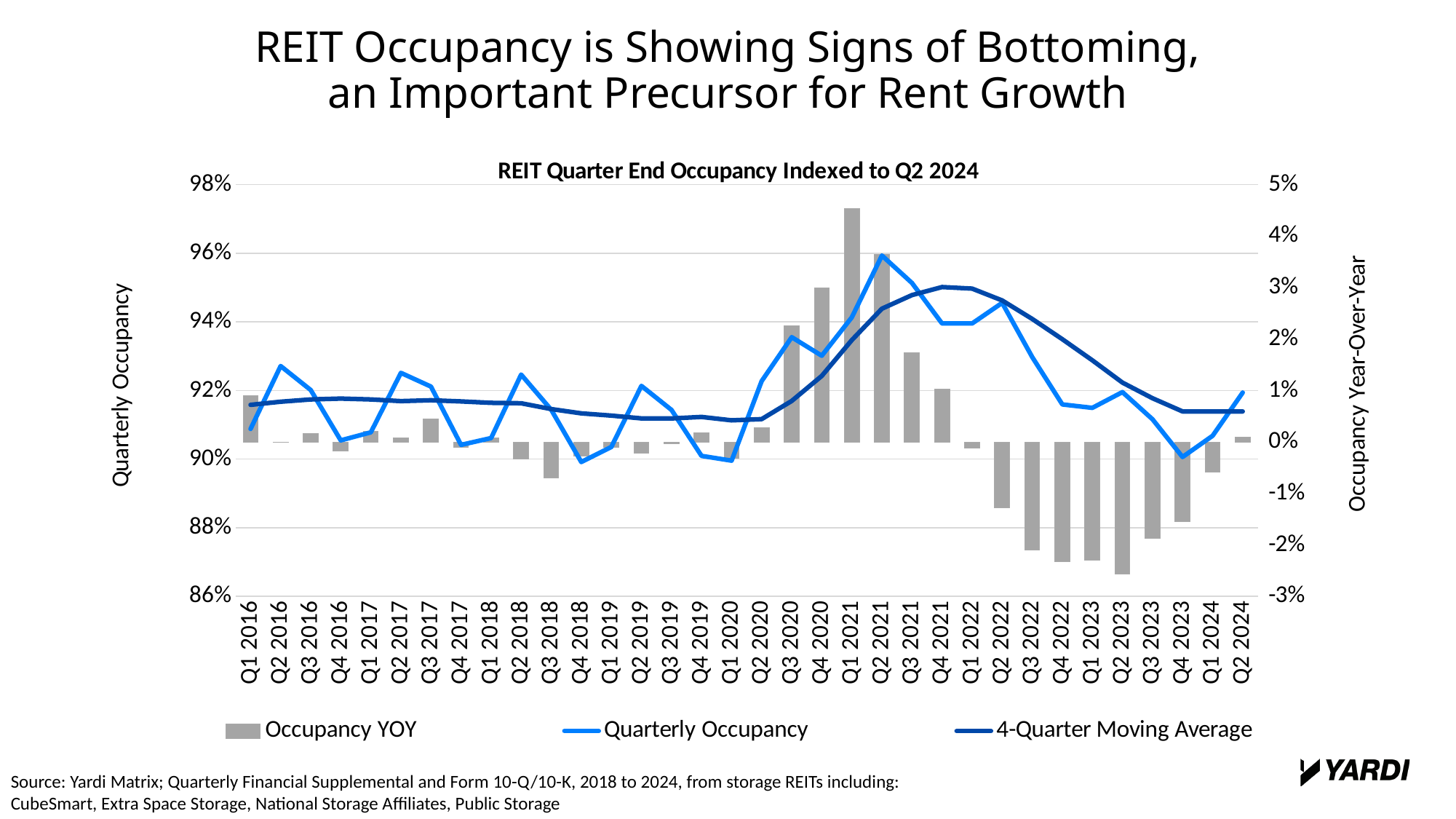
Is the Occupancy YOY value for Q2 2023 greater or less than -2%? less What is the title of the chart? REIT Quarter End Occupancy Indexed to Q2 2024 Does the Quarterly Occupancy line rise or fall from Q2 2021 to Q4 2023? fall In which quarter is the Occupancy YOY bar the lowest? Q2 2023 In which quarter is the Occupancy YOY bar the highest? Q1 2021 Which is larger, the Quarterly Occupancy value for Q2 2021 or for Q2 2024? Q2 2021 How many quarters are shown along the x axis? 34 In which quarter does the Quarterly Occupancy line reach its highest point? Q2 2021 Is the Occupancy YOY value for Q1 2021 greater or less than 4%? greater How many series does the legend list? 3 Is the Quarterly Occupancy value for Q2 2021 greater or less than 94%? greater What type of chart is shown on the slide? A combined bar and line chart